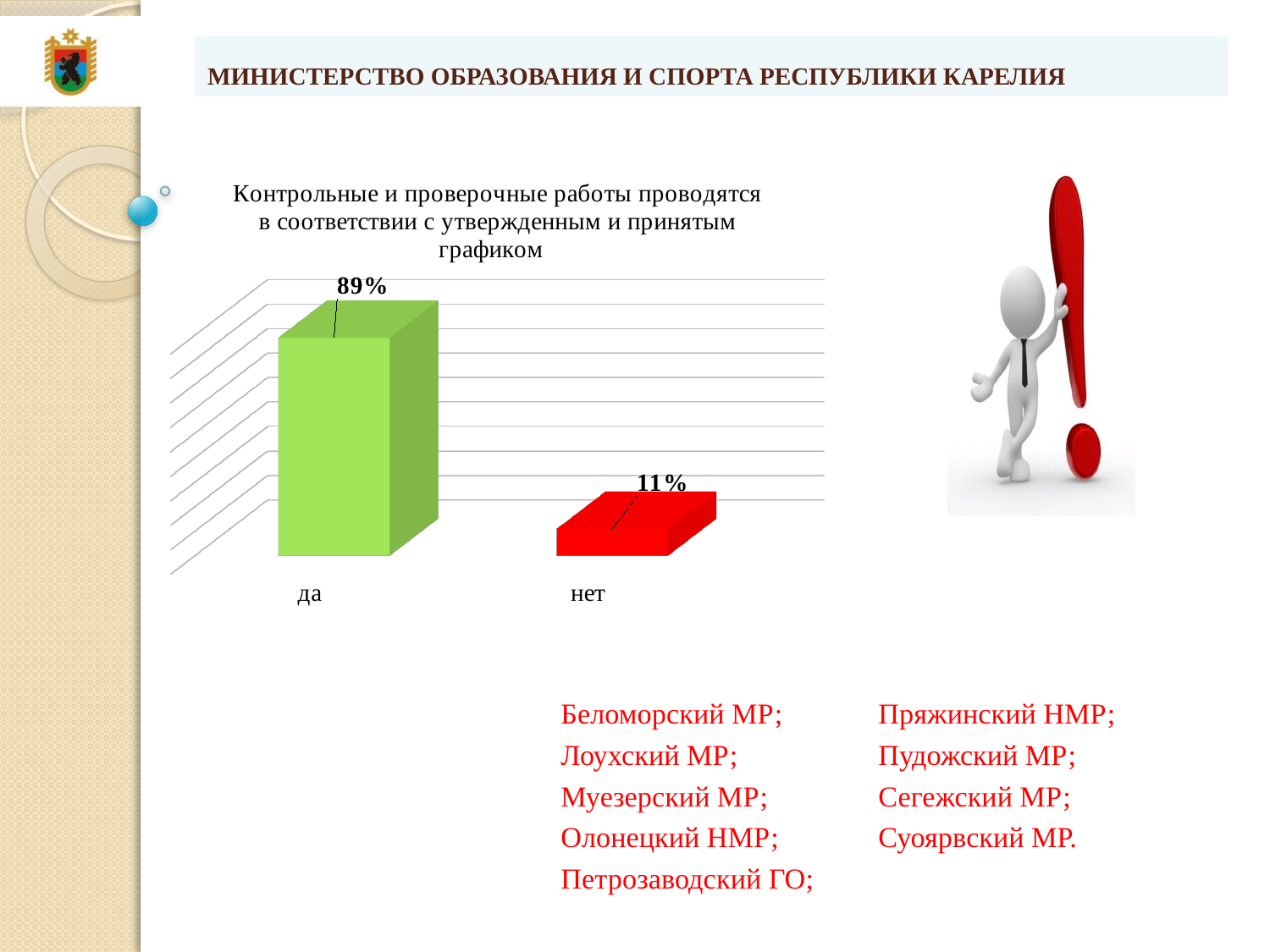
What is the value for "нет"? 11% What kind of chart is shown on the slide? bar chart Which is larger, the value for "да" or the value for "нет"? да What is the total of the two values shown in the chart? 100% What colour is the bar for "нет"? red What is the value for "да"? 89% How many categories are shown in the chart? 2 What is the difference between the values for "да" and "нет"? 78% What is the title of the chart? Контрольные и проверочные работы проводятся в соответствии с утвержденным и принятым графиком Which category has the highest value? да Which category has the lowest value? нет